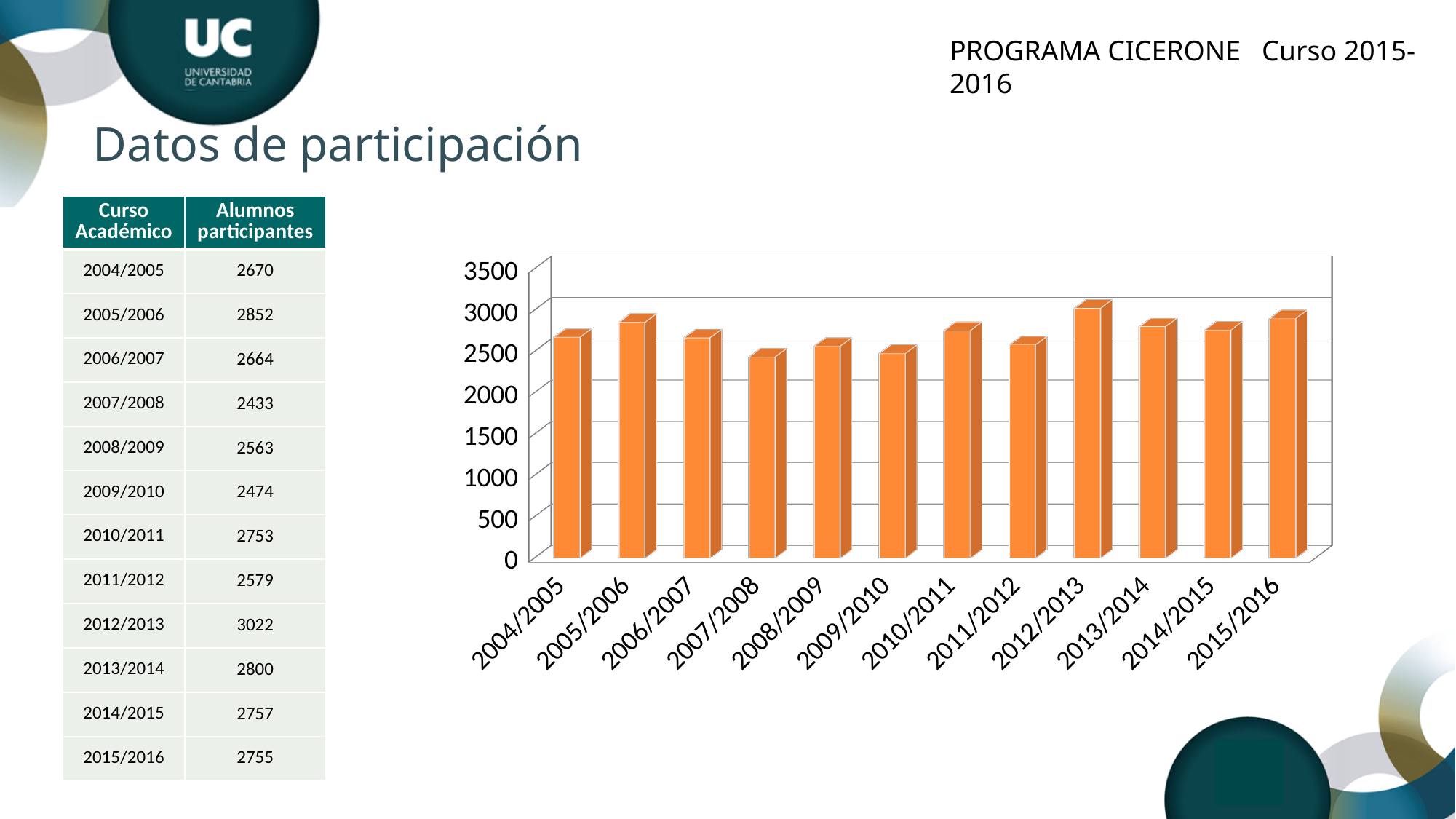
What is the highest value shown on the vertical axis of the chart? 3500 What kind of chart is shown on the slide? bar chart What is the difference in participating students between 2012/2013 and 2007/2008? 589 How many participating students were there in 2007/2008? 2433 How many academic years (categories) are plotted on the chart? 12 Which academic year has the highest number of participating students? 2012/2013 How many participating students were there in 2015/2016? 2755 Is the value for 2009/2010 greater or less than 2500? less Which year had more participating students, 2005/2006 or 2009/2010? 2005/2006 Is the value for 2012/2013 greater or less than 3000? greater How many participating students were there in 2012/2013? 3022 Which academic year has the lowest number of participating students? 2007/2008